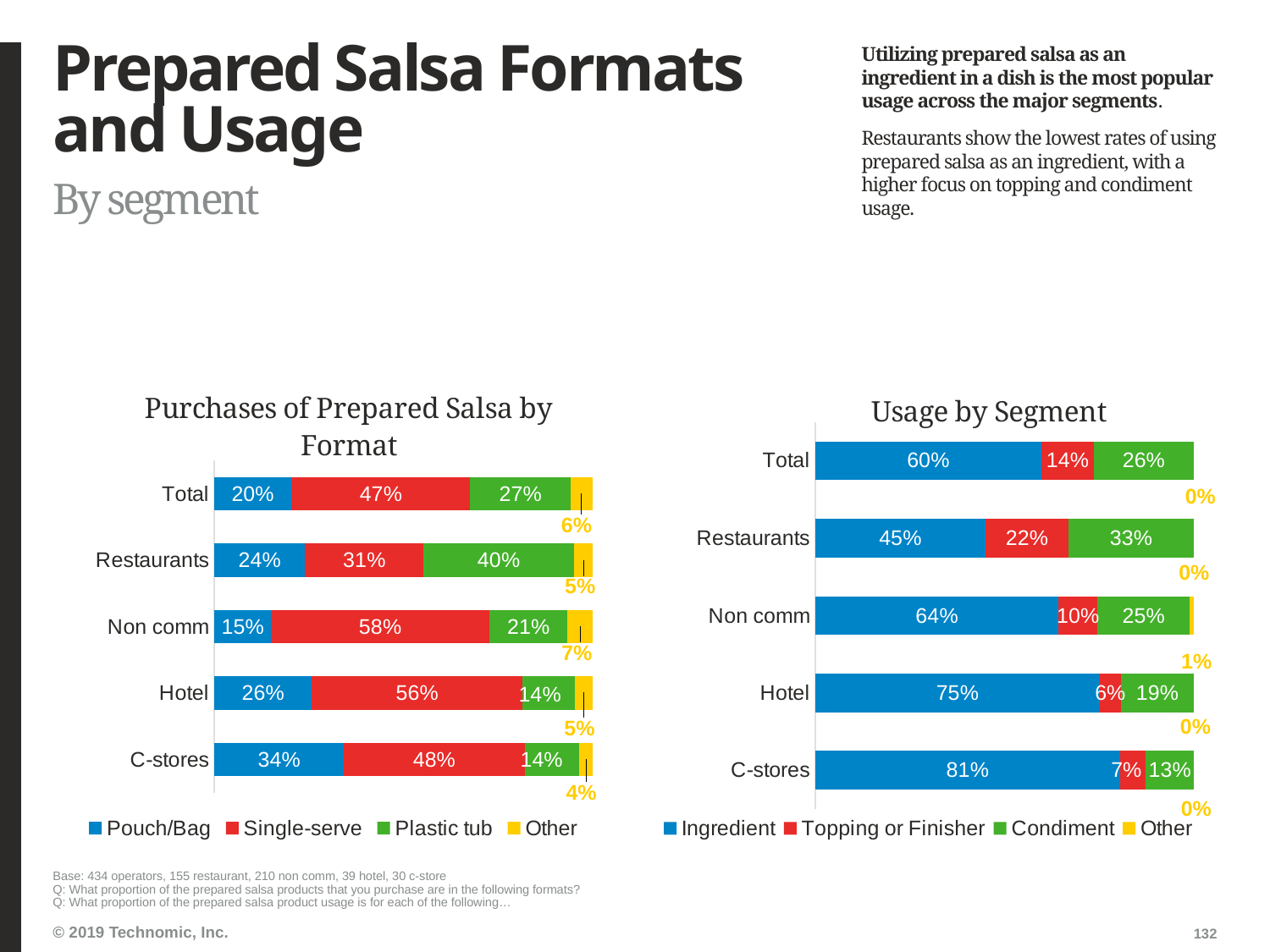
In the 'Purchases of Prepared Salsa by Format' chart, which segment has the highest Pouch/Bag value? C-stores In the 'Purchases of Prepared Salsa by Format' chart, what is the difference between the Plastic tub values for Restaurants and Hotel? 26% In the 'Purchases of Prepared Salsa by Format' chart, what is the Other value for Total? 6% How many series does the legend of the 'Purchases of Prepared Salsa by Format' chart list? 4 In the 'Usage by Segment' chart, which is larger: the Condiment value for Restaurants or the Condiment value for Total? Restaurants In the 'Usage by Segment' chart, what is the Ingredient value for C-stores? 81% In the 'Usage by Segment' chart, which segment has the lowest Ingredient value? Restaurants In the 'Usage by Segment' chart, which segment has the highest Ingredient value? C-stores What type of chart is 'Usage by Segment'? Stacked bar chart How many segments are shown in the 'Usage by Segment' chart? 5 In the 'Purchases of Prepared Salsa by Format' chart, what is the Single-serve value for Non comm? 58% In the 'Usage by Segment' chart, what is the Other value for Non comm? 1%